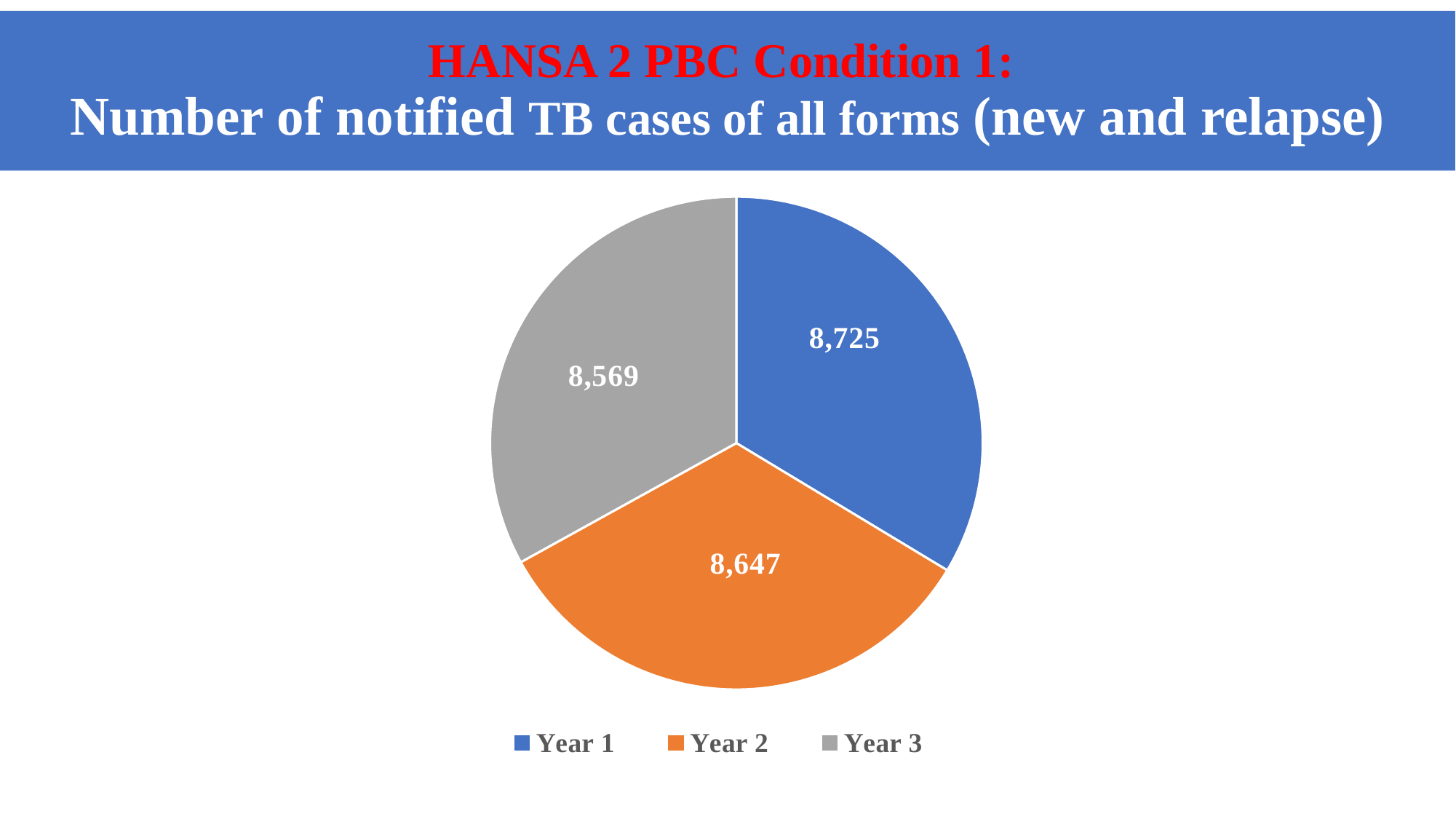
What kind of chart is shown on the slide? Pie chart How many slices does the pie chart have? 3 What is the number of notified TB cases for Year 2? 8,647 What is the difference between the Year 1 and Year 3 values? 156 Which is larger, the value for Year 2 or the value for Year 3? Year 2 What is the difference between the Year 1 and Year 2 values? 78 Which year has the lowest number of notified TB cases? Year 3 What is the number of notified TB cases for Year 1? 8,725 What is the number of notified TB cases for Year 3? 8,569 Which year has the highest number of notified TB cases? Year 1 What is the total number of notified TB cases across all three years? 25,941 Which colour represents Year 2 in the pie chart? Orange